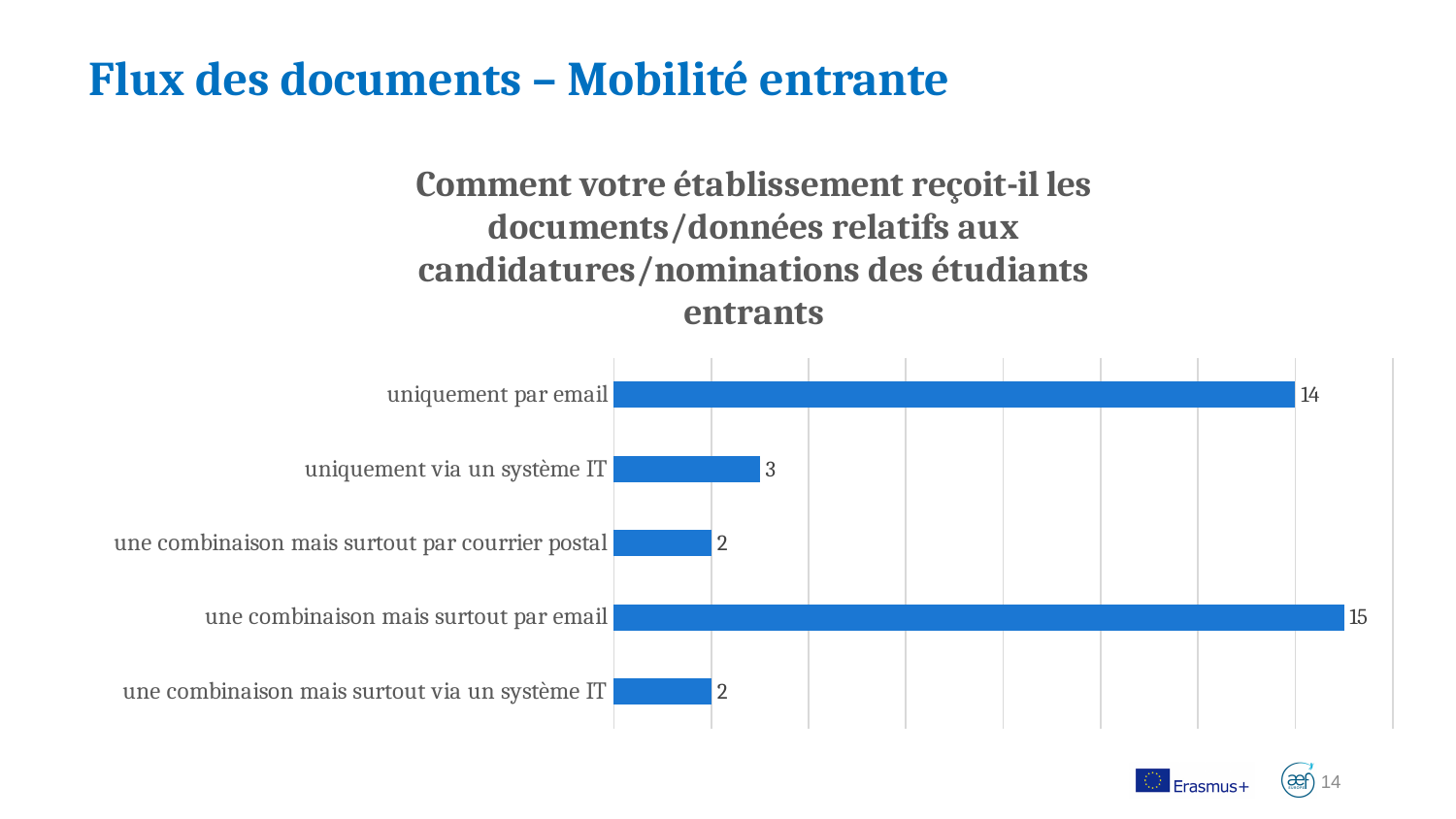
Which is larger, the value for "uniquement via un système IT" or the value for "une combinaison mais surtout par courrier postal"? uniquement via un système IT What is the value for "uniquement par email"? 14 What is the title of the chart? Comment votre établissement reçoit-il les documents/données relatifs aux candidatures/nominations des étudiants entrants What kind of chart is shown on the slide? Bar chart How many categories are shown in the chart? 5 Which category has the highest value? une combinaison mais surtout par email What is the value for "une combinaison mais surtout par email"? 15 What is the value for "uniquement via un système IT"? 3 What is the value for "une combinaison mais surtout via un système IT"? 2 What is the value for "une combinaison mais surtout par courrier postal"? 2 What is the difference between the values for "une combinaison mais surtout par email" and "uniquement par email"? 1 What is the difference between the values for "uniquement par email" and "uniquement via un système IT"? 11